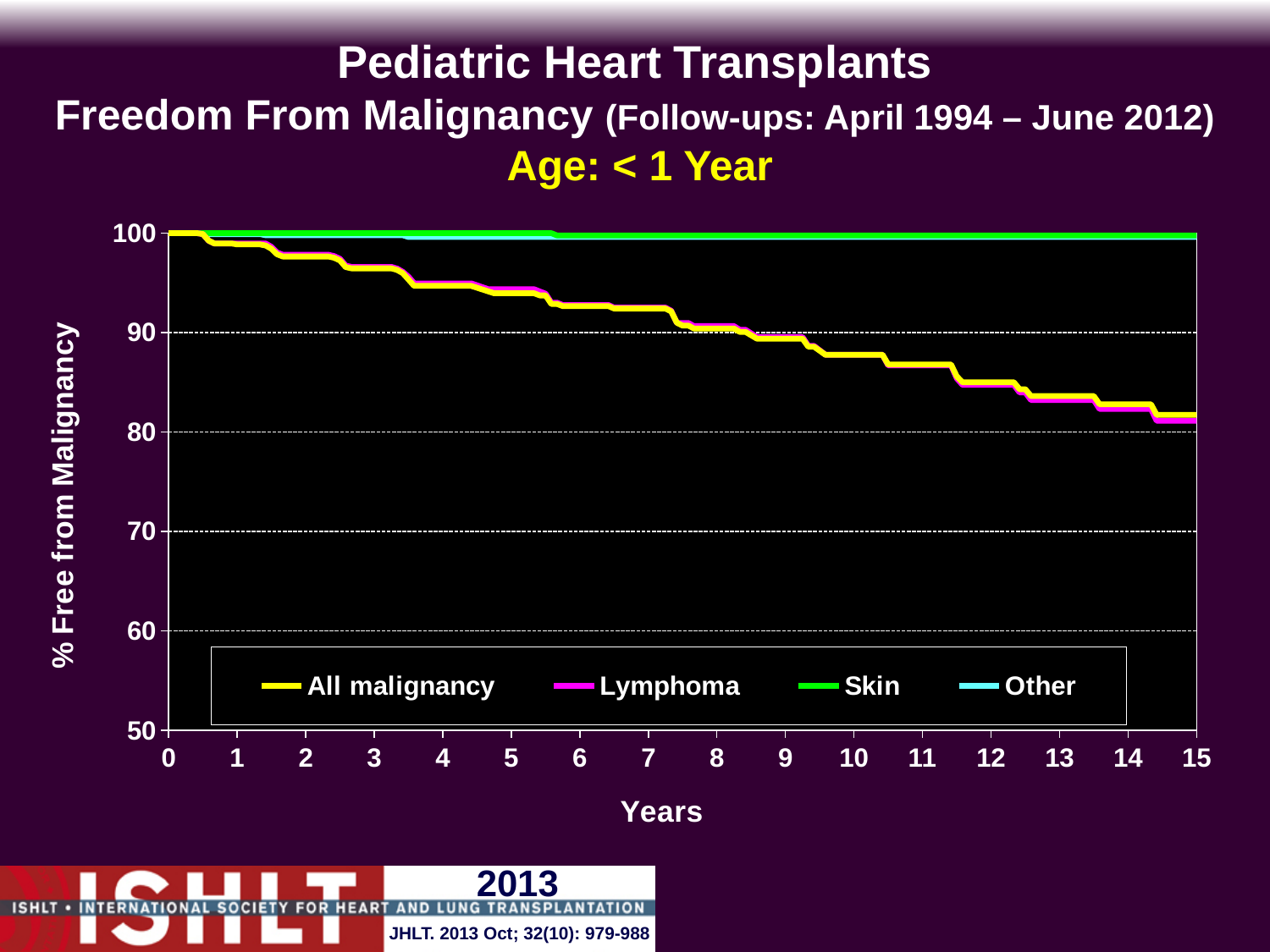
Does the All malignancy line rise or fall as years increase? Fall Which series has the lowest value at 15 years? Lymphoma How many series does the legend list? 4 Is the value for Lymphoma at 10 years greater or less than 90? less Is the value for All malignancy at 15 years greater or less than 90? less What is the label of the y axis? % Free from Malignancy Which series are listed in the legend? All malignancy, Lymphoma, Skin, Other Is the value for Skin at 15 years greater or less than 90? greater What is the highest value shown on the x axis (Years)? 15 What kind of chart is shown on the slide? Line chart At 15 years, which series has the higher value, Skin or All malignancy? Skin